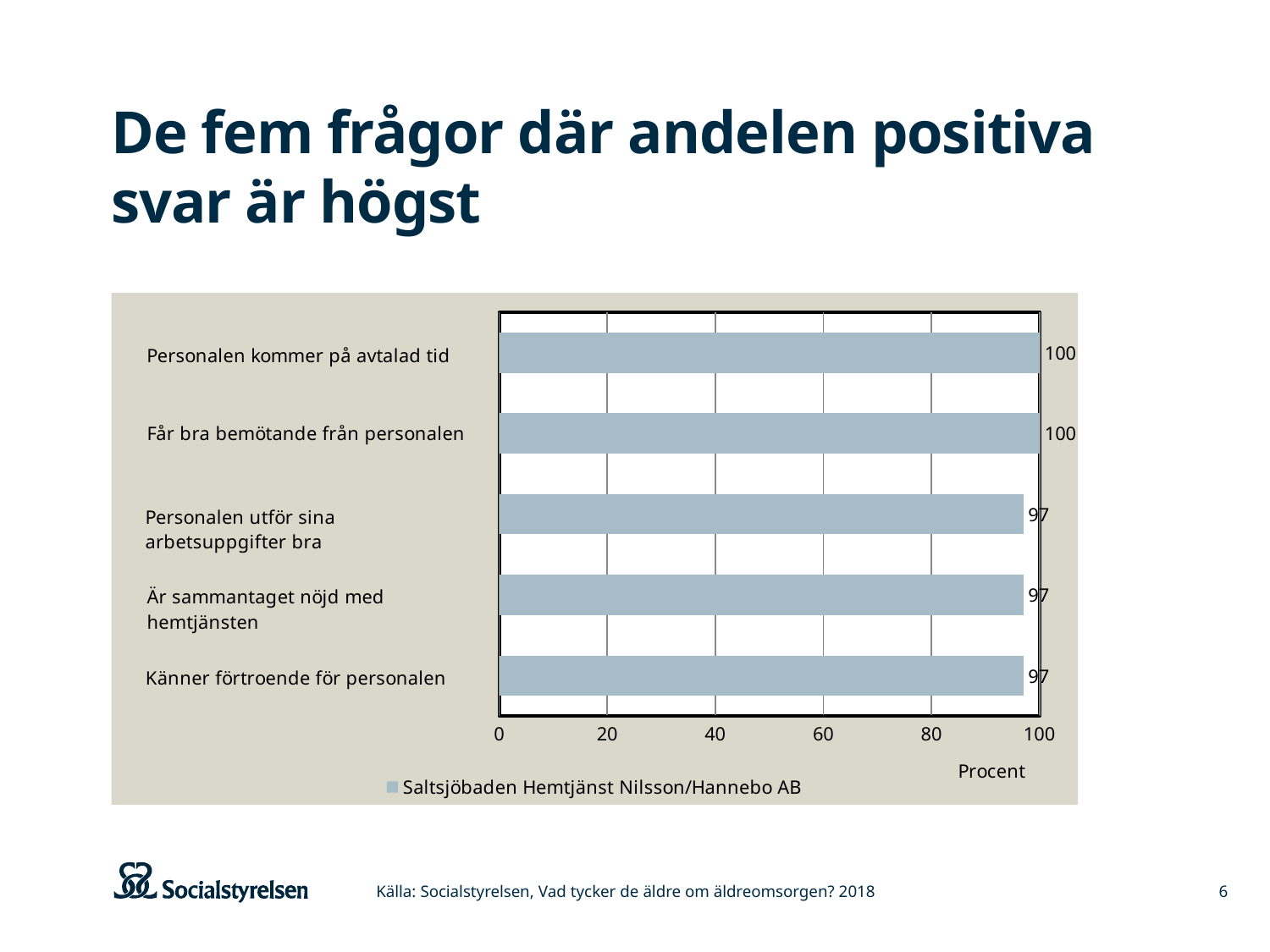
What is the value for "Personalen kommer på avtalad tid"? 100 What is the label of the horizontal axis? Procent What is the value for "Får bra bemötande från personalen"? 100 What type of chart is shown on the slide? bar chart Which is larger, the value for "Får bra bemötande från personalen" or the value for "Är sammantaget nöjd med hemtjänsten"? Får bra bemötande från personalen How many categories are shown in the chart? 5 What is the difference between the values for "Personalen kommer på avtalad tid" and "Känner förtroende för personalen"? 3 What is the value for "Är sammantaget nöjd med hemtjänsten"? 97 How many series does the legend list? 1 What is the value for "Känner förtroende för personalen"? 97 What is the name of the series shown in the legend? Saltsjöbaden Hemtjänst Nilsson/Hannebo AB What is the value for "Personalen utför sina arbetsuppgifter bra"? 97